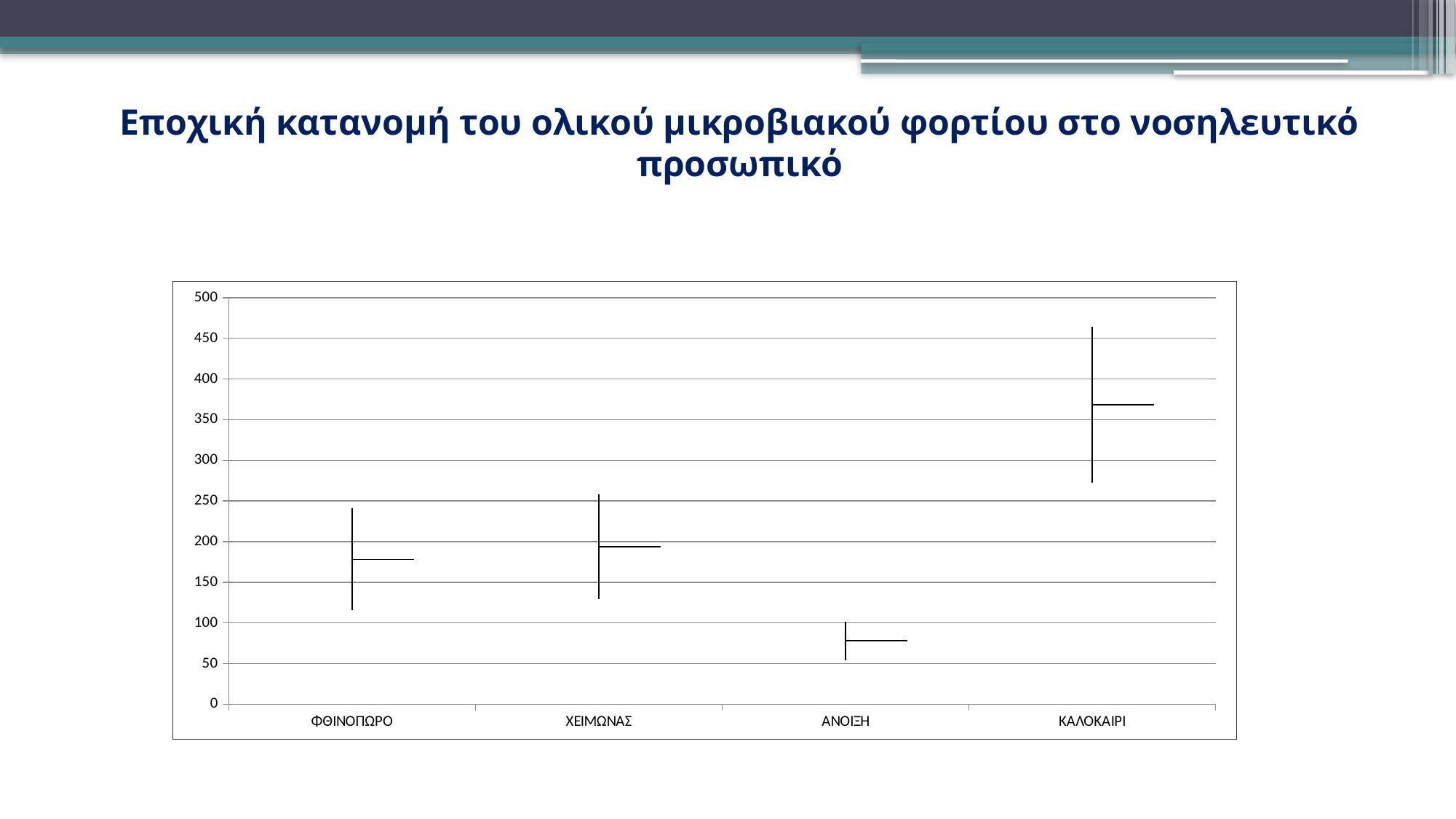
Which has the larger horizontal marker value, ΦΘΙΝΟΠΩΡΟ or ΑΝΟΙΞΗ? ΦΘΙΝΟΠΩΡΟ Is the horizontal marker value for ΑΝΟΙΞΗ greater or less than 100? less How many categories are shown on the x axis of the chart? 4 Is the top of the vertical line for ΚΑΛΟΚΑΙΡΙ greater or less than 400? greater Is the top of the vertical line for ΧΕΙΜΩΝΑΣ greater or less than 300? less Which category has the lowest values on the chart? ΑΝΟΙΞΗ Which category has the highest values on the chart? ΚΑΛΟΚΑΙΡΙ What is the maximum value shown on the vertical axis of the chart? 500 What is the title of the slide containing the chart? Εποχική κατανομή του ολικού μικροβιακού φορτίου στο νοσηλευτικό προσωπικό Which has the larger horizontal marker value, ΚΑΛΟΚΑΙΡΙ or ΑΝΟΙΞΗ? ΚΑΛΟΚΑΙΡΙ